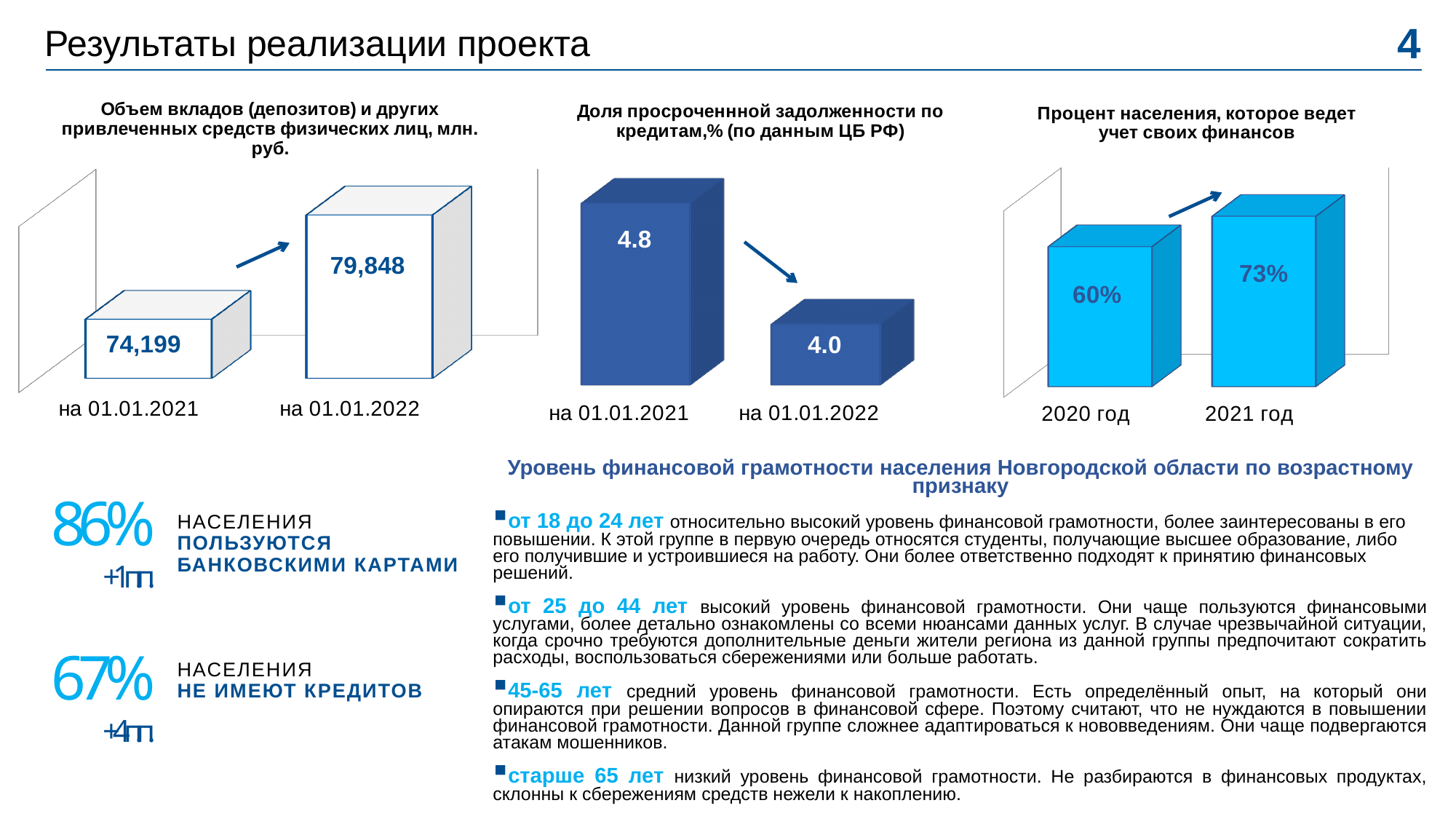
In the left chart (Объем вкладов), by how much did the value increase from 01.01.2021 to 01.01.2022? 5,649 In the right chart (Процент населения, которое ведет учет своих финансов), which year has the higher value? 2021 год In the left chart (Объем вкладов), what is the value for на 01.01.2021? 74,199 In the middle chart (Доля просроченной задолженности по кредитам), do the values rise or fall from 01.01.2021 to 01.01.2022? fall How many charts are shown on the slide? 3 In the middle chart (Доля просроченной задолженности по кредитам), what is the value for на 01.01.2022? 4.0 In the left chart (Объем вкладов), do the values rise or fall from 01.01.2021 to 01.01.2022? rise In the middle chart (Доля просроченной задолженности по кредитам), what is the difference between the 01.01.2021 and 01.01.2022 values? 0.8 In the middle chart (Доля просроченной задолженности по кредитам), what is the value for на 01.01.2021? 4.8 In the right chart (Процент населения, которое ведет учет своих финансов), by how many percentage points did the value grow from 2020 to 2021? 13 percentage points In the right chart (Процент населения, которое ведет учет своих финансов), what is the value for 2020 год? 60% In the left chart (Объем вкладов), what is the value for на 01.01.2022? 79,848